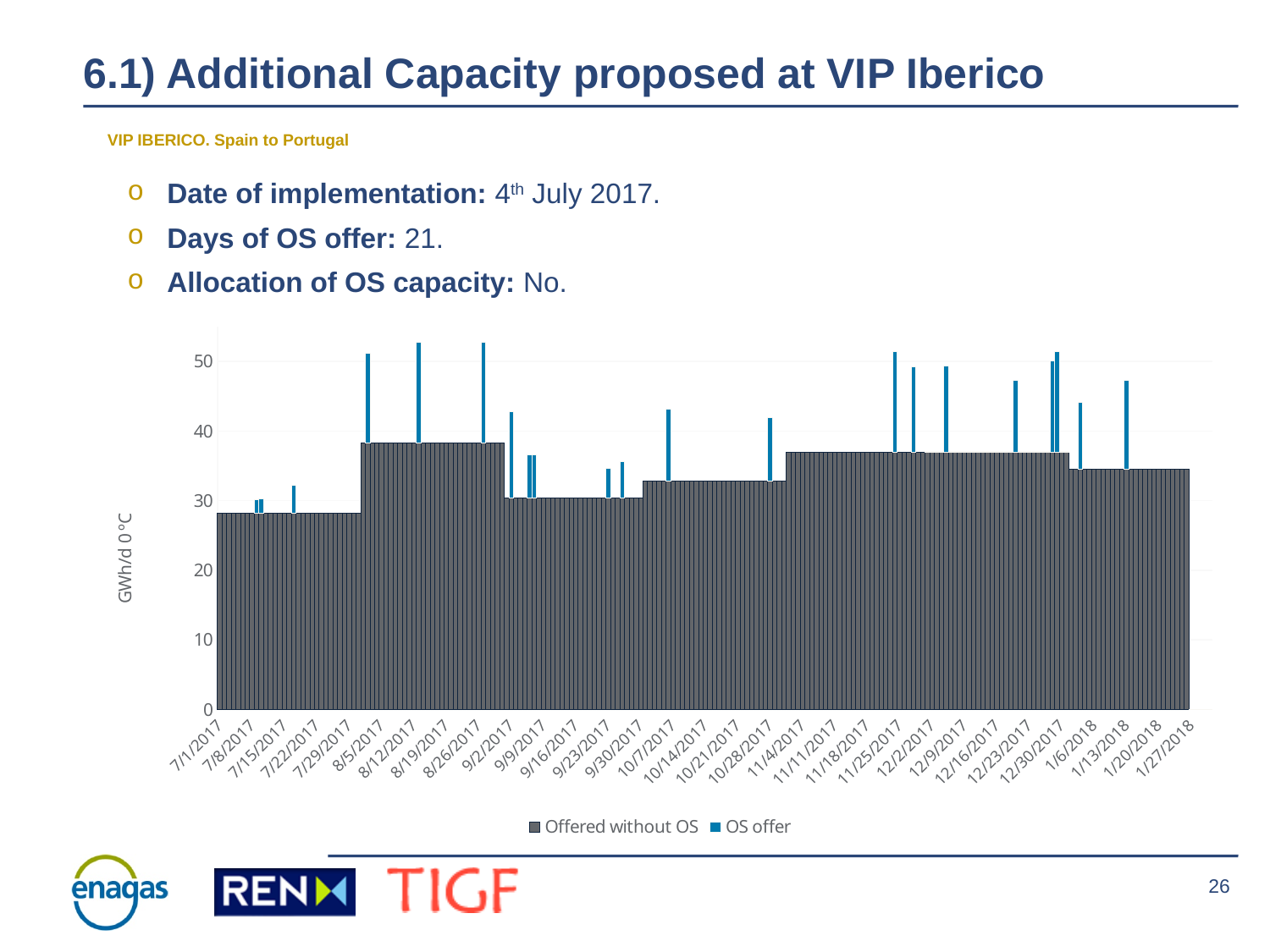
What is the highest value shown on the vertical axis of the chart? 50 What is the label on the vertical axis of the chart? GWh/d 0 °C What are the two series named in the chart legend? Offered without OS; OS offer What kind of chart is shown on the slide? Stacked bar chart Is the Offered without OS value on 11/11/2017 greater or less than 40? less Is the Offered without OS value on 8/12/2017 greater or less than 30? greater Does the Offered without OS value rise or fall between 8/26/2017 and 9/2/2017? Fall Which date has the larger Offered without OS value, 7/8/2017 or 8/12/2017? 8/12/2017 Does the Offered without OS value rise or fall between 7/29/2017 and 8/5/2017? Rise Is the Offered without OS value on 7/1/2017 greater or less than 40? less How many series does the chart legend list? 2